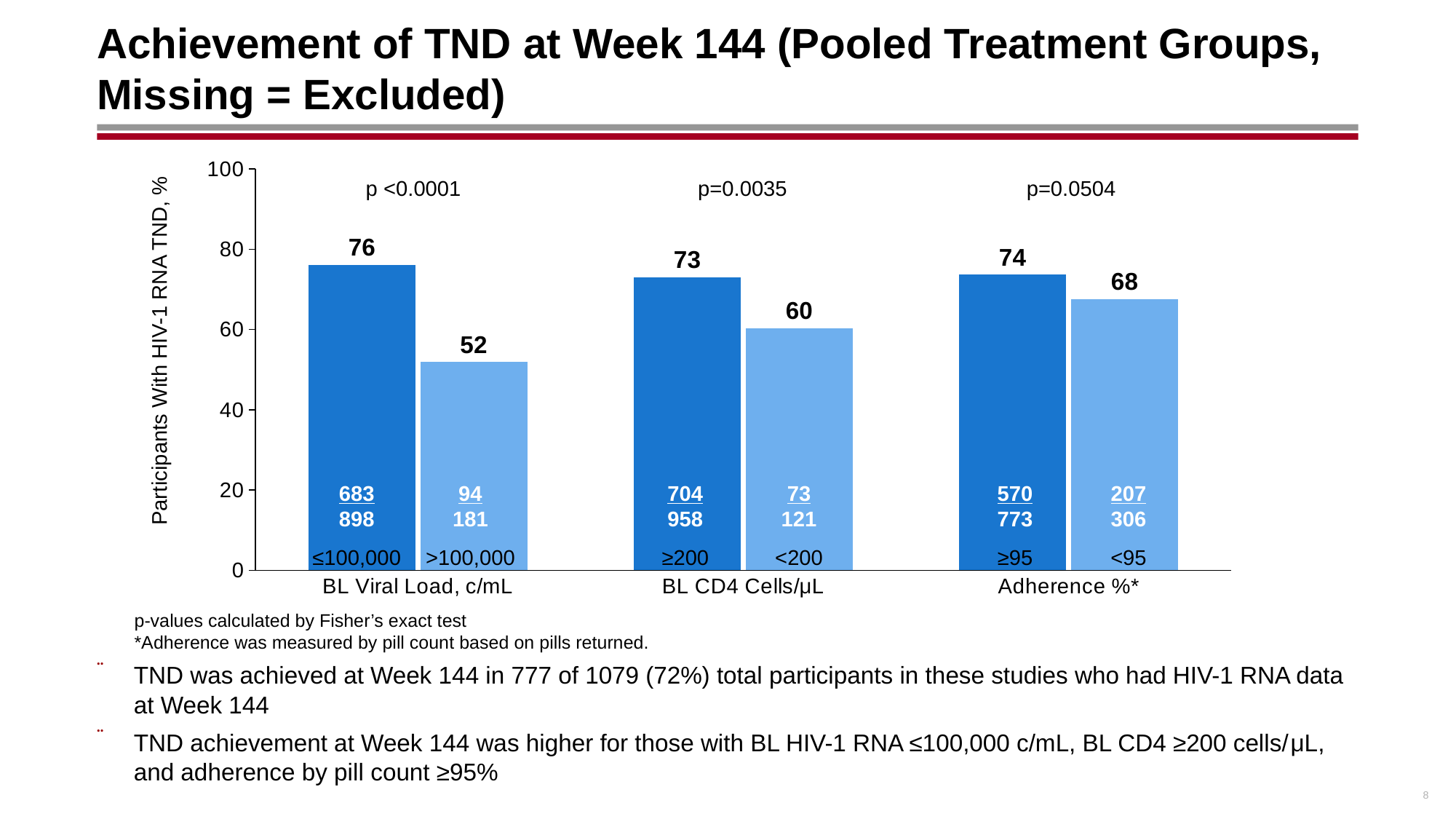
What is the y-axis label of the chart? Participants With HIV-1 RNA TND, % Which bar shows the highest percentage of participants with HIV-1 RNA TND? ≤100,000 (BL Viral Load) What percentage of participants with BL viral load ≤100,000 c/mL achieved TND at Week 144? 76 What percentage of participants with BL CD4 <200 cells/µL achieved TND? 60 How many bars are plotted in the chart? 6 What is the difference in TND percentage between BL CD4 ≥200 and <200 cells/µL? 13 Which group has a higher TND percentage: adherence ≥95% or adherence <95%? Adherence ≥95% What p-value is shown for the BL CD4 comparison? p=0.0035 Which bar shows the lowest percentage of participants with HIV-1 RNA TND? >100,000 (BL Viral Load) What percentage of participants with BL viral load >100,000 c/mL achieved TND at Week 144? 52 What percentage of participants with adherence <95% achieved TND? 68 What type of chart is shown on the slide? Bar chart